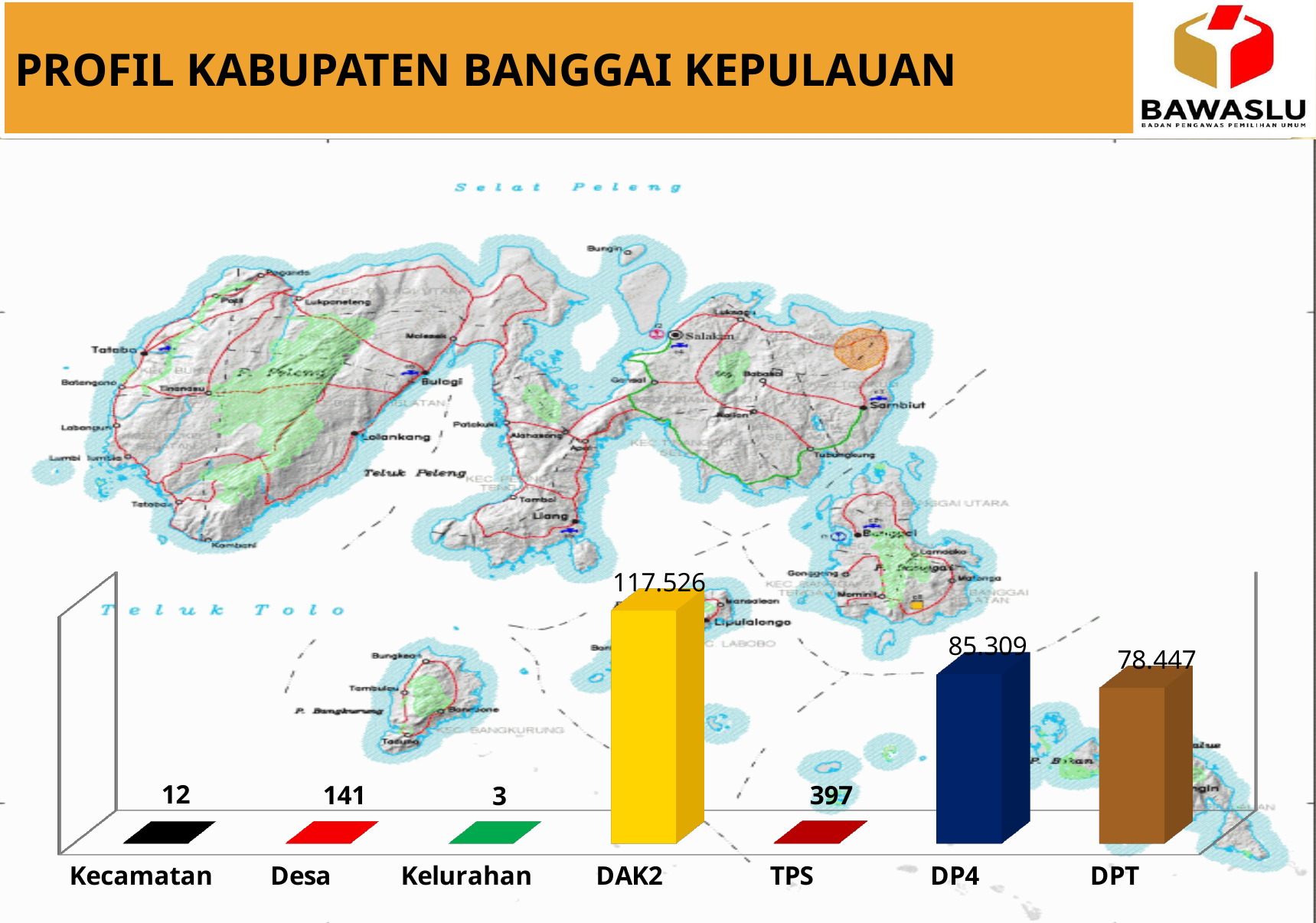
Which is larger, the value for Desa or the value for Kecamatan? Desa What is the value shown for Desa? 141 What is the value shown for DAK2? 117.526 What is the value shown for DPT? 78.447 How many categories are shown on the chart? 7 Which category has the lowest value? Kelurahan What is the value shown for TPS? 397 What is the value shown for DP4? 85.309 What kind of chart is shown on the slide? Bar chart What is the difference between the values for DAK2 and DP4? 32.217 Which category has the highest value? DAK2 What is the difference between the values for DP4 and DPT? 6.862